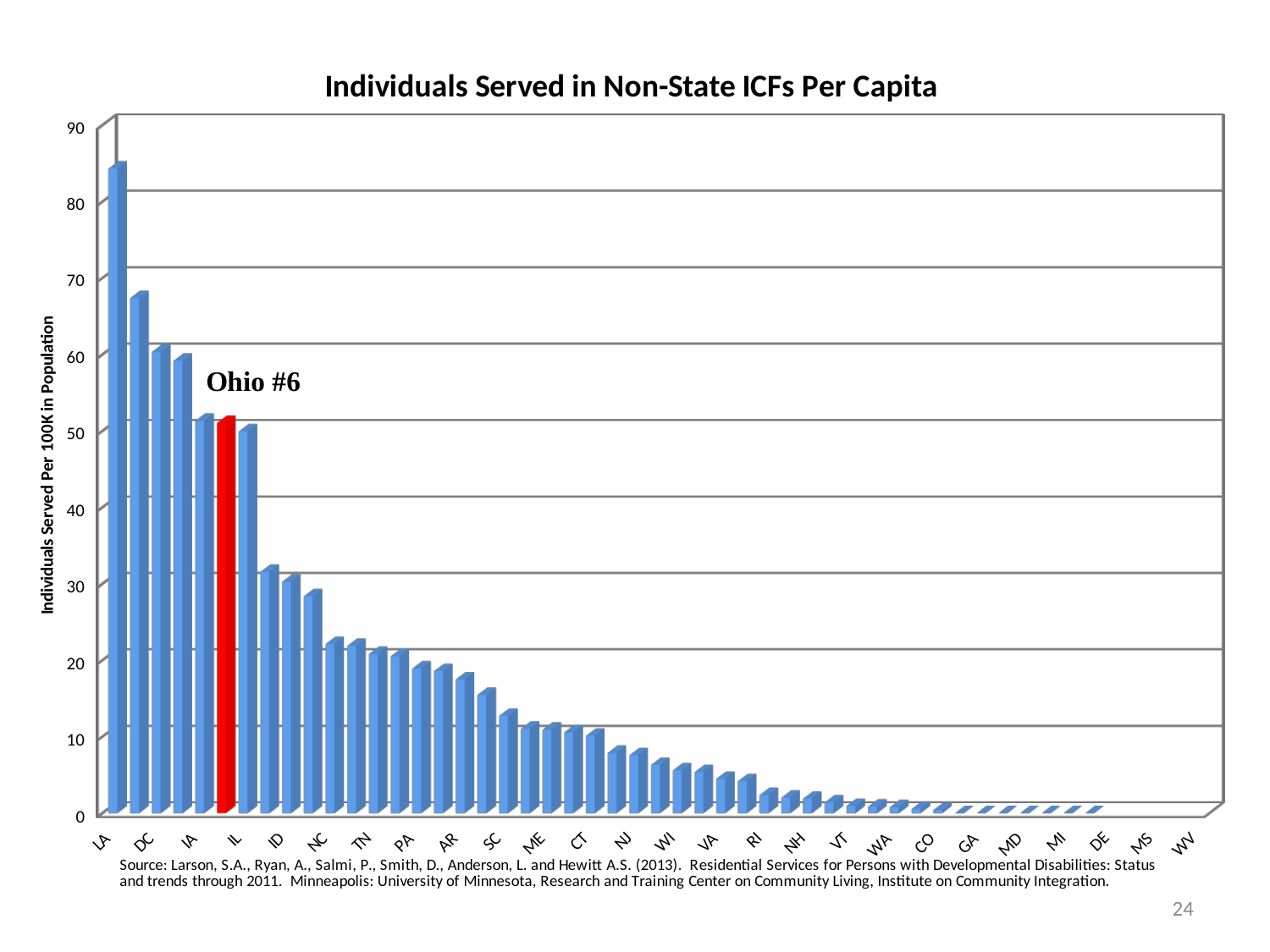
Which is larger, the value for LA or the value for DC? LA Is the value for LA greater or less than 80? greater What kind of chart is shown on the slide? bar chart What rank does the slide give Ohio in individuals served in non-state ICFs per capita? #6 Which state has the highest number of individuals served in non-state ICFs per capita? LA What is the label on the y axis of the chart? Individuals Served Per 100K in Population Is the value for ID greater or less than 20? greater Which is larger, the value for ID or the value for TN? ID Is the value for NJ greater or less than 10? less Do the values rise or fall moving from left to right along the x axis? fall